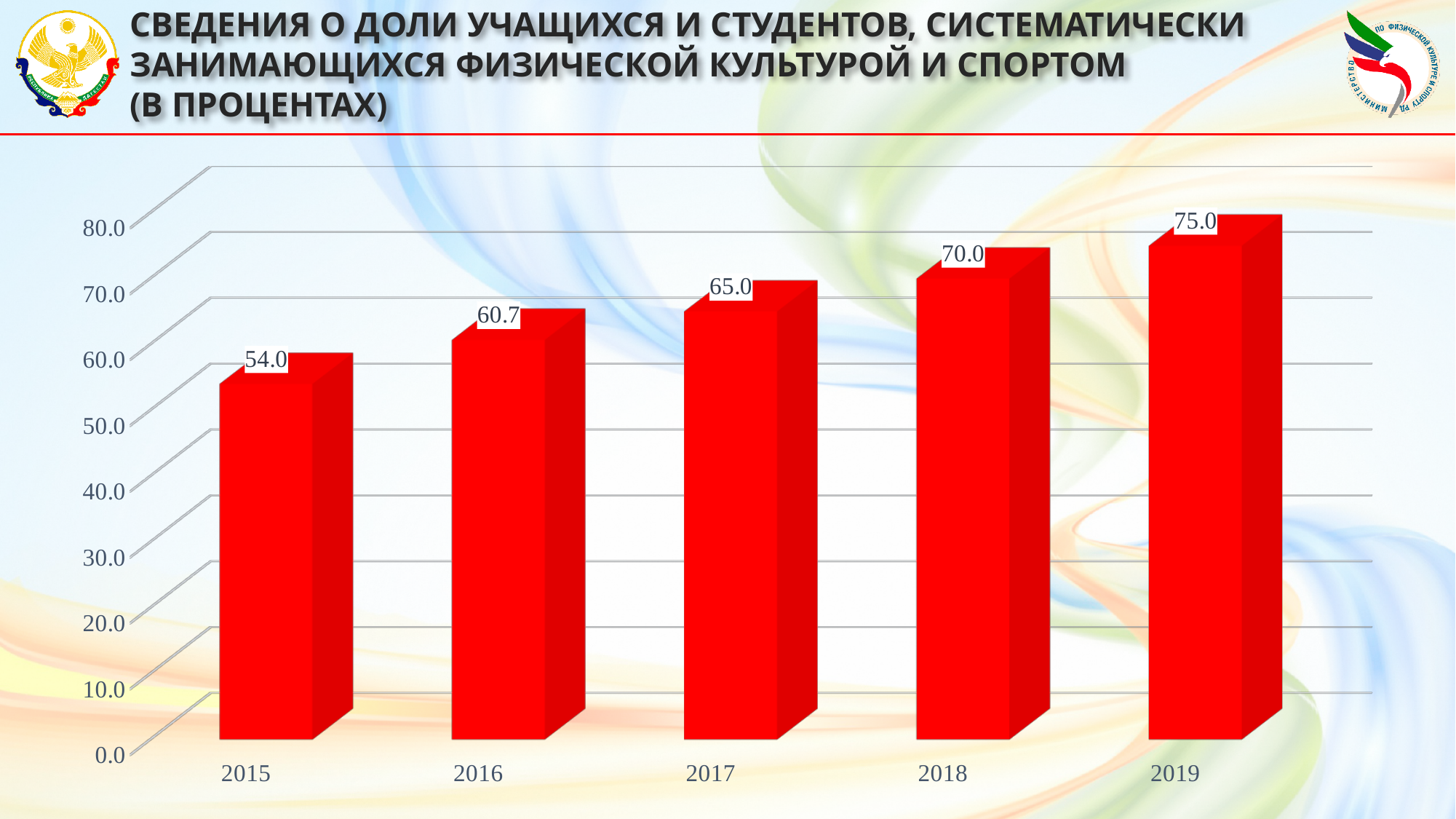
What kind of chart is shown on the slide? bar chart Which year has the lowest value? 2015 Do the values rise or fall from 2015 to 2019? rise What is the value for 2017? 65.0 What is the difference between the values for 2018 and 2017? 5.0 What is the difference between the values for 2019 and 2015? 21.0 Which year has the highest value? 2019 Which is larger, the value for 2016 or the value for 2018? 2018 What is the value for 2015? 54.0 How many years are shown on the x axis? 5 What is the value for 2019? 75.0 What is the value for 2016? 60.7